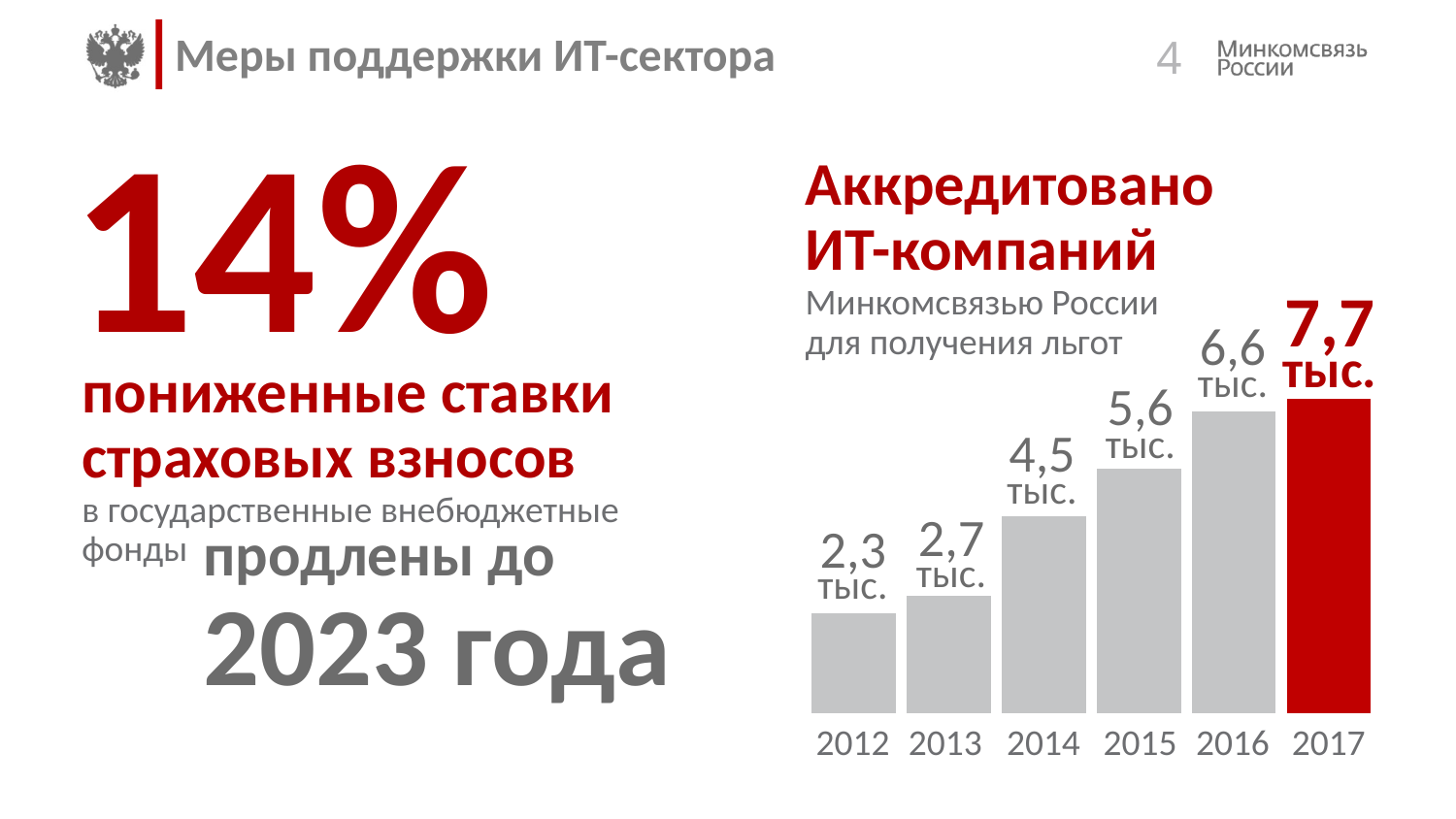
What is the value for 2012 in the chart? 2,3 тыс. Do the values rise or fall from 2012 to 2017? rise What is the difference between the values for 2016 and 2015? 1,0 тыс. What is the value for 2014 in the chart? 4,5 тыс. What is the difference between the values for 2017 and 2012? 5,4 тыс. Which bar in the chart is coloured red rather than grey? 2017 Which year has the highest value in the chart? 2017 How many years are shown on the x axis of the chart? 6 Which is larger, the value for 2013 or the value for 2015? 2015 What is the value for 2017 in the chart? 7,7 тыс. Which year has the lowest value in the chart? 2012 What type of chart is shown on the slide? bar chart